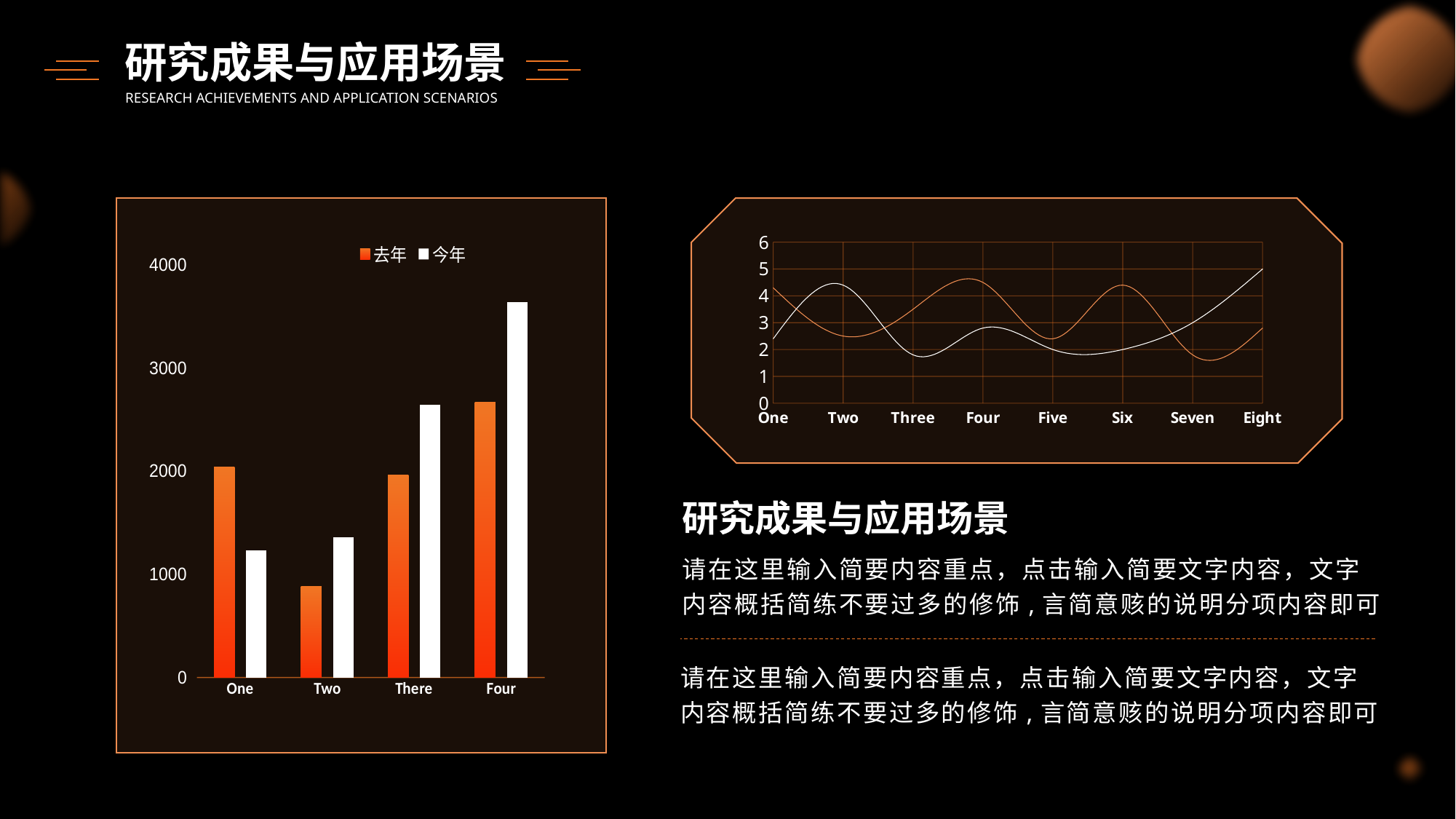
In the bar chart on the left, how many categories are shown on the x axis? 4 In the bar chart on the left, for category One, which series has the larger value, 去年 or 今年? 去年 In the line chart on the right, how many categories are shown on the x axis? 8 In the line chart on the right, is the value of the white line at Eight greater or less than 4? greater In the bar chart on the left, is the value for 去年 in category Two greater or less than 1000? less What kind of chart is the chart on the right side of the slide? line chart In the bar chart on the left, which series is shown in orange according to the legend? 去年 In the bar chart on the left, is the value for 今年 in category Four greater or less than 3000? greater What kind of chart is the chart on the left side of the slide? bar chart In the bar chart on the left, how many series does the legend list? 2 In the bar chart on the left, which category has the lowest value for 去年? Two In the bar chart on the left, which category has the highest value for 今年? Four